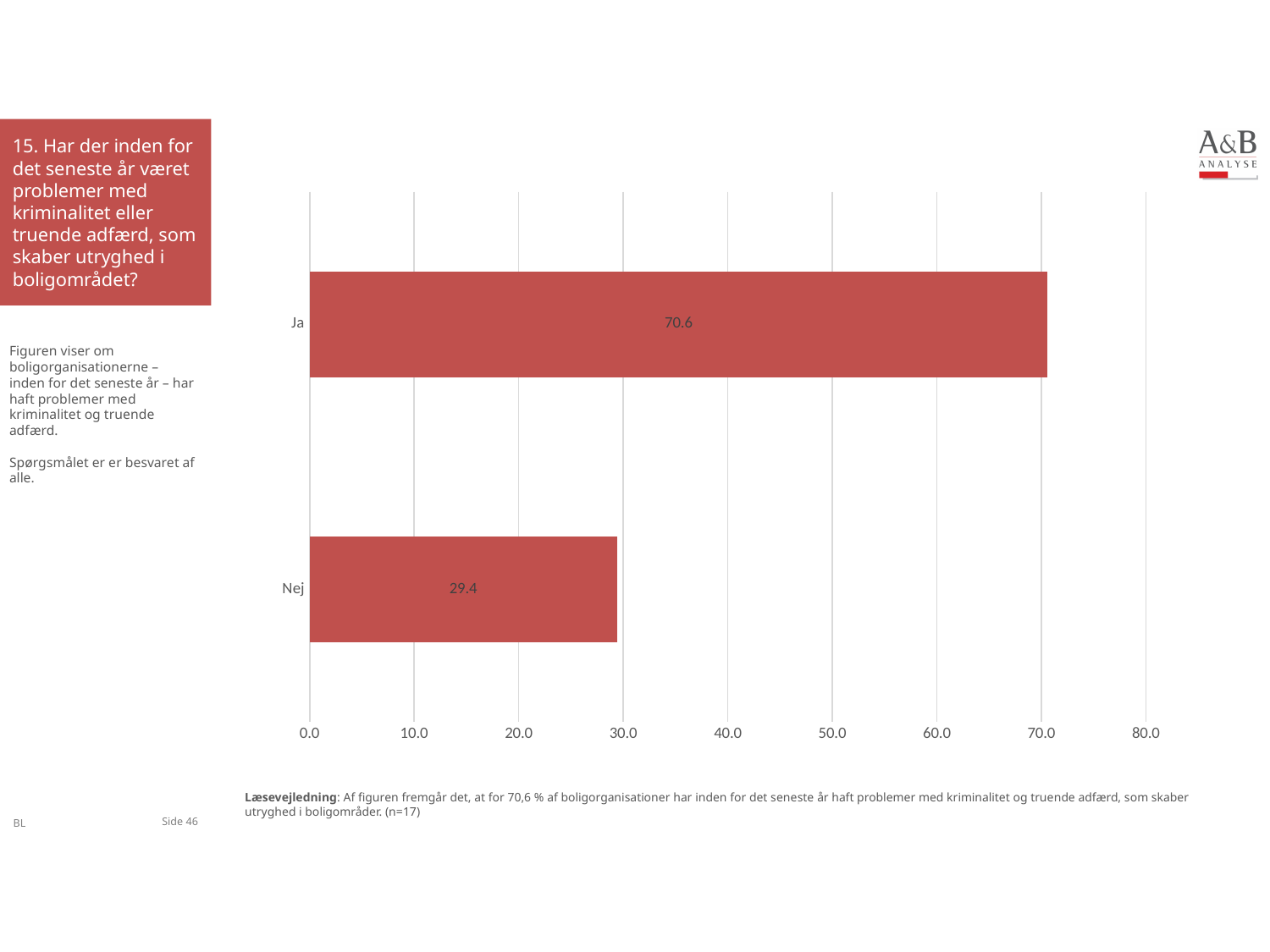
Which category has the highest value? Ja Is the value for "Ja" greater or less than 60.0? greater What is the value for "Nej"? 29.4 Is the value for "Nej" greater or less than 30.0? less What is the total of the values for "Ja" and "Nej"? 100.0 How many categories are shown in the chart? 2 What is the difference between the values for "Ja" and "Nej"? 41.2 What is the value for "Ja"? 70.6 Which category has the lowest value? Nej What is the highest value shown on the x axis? 80.0 What kind of chart is shown on the slide? bar chart Which is larger, the value for "Ja" or the value for "Nej"? Ja